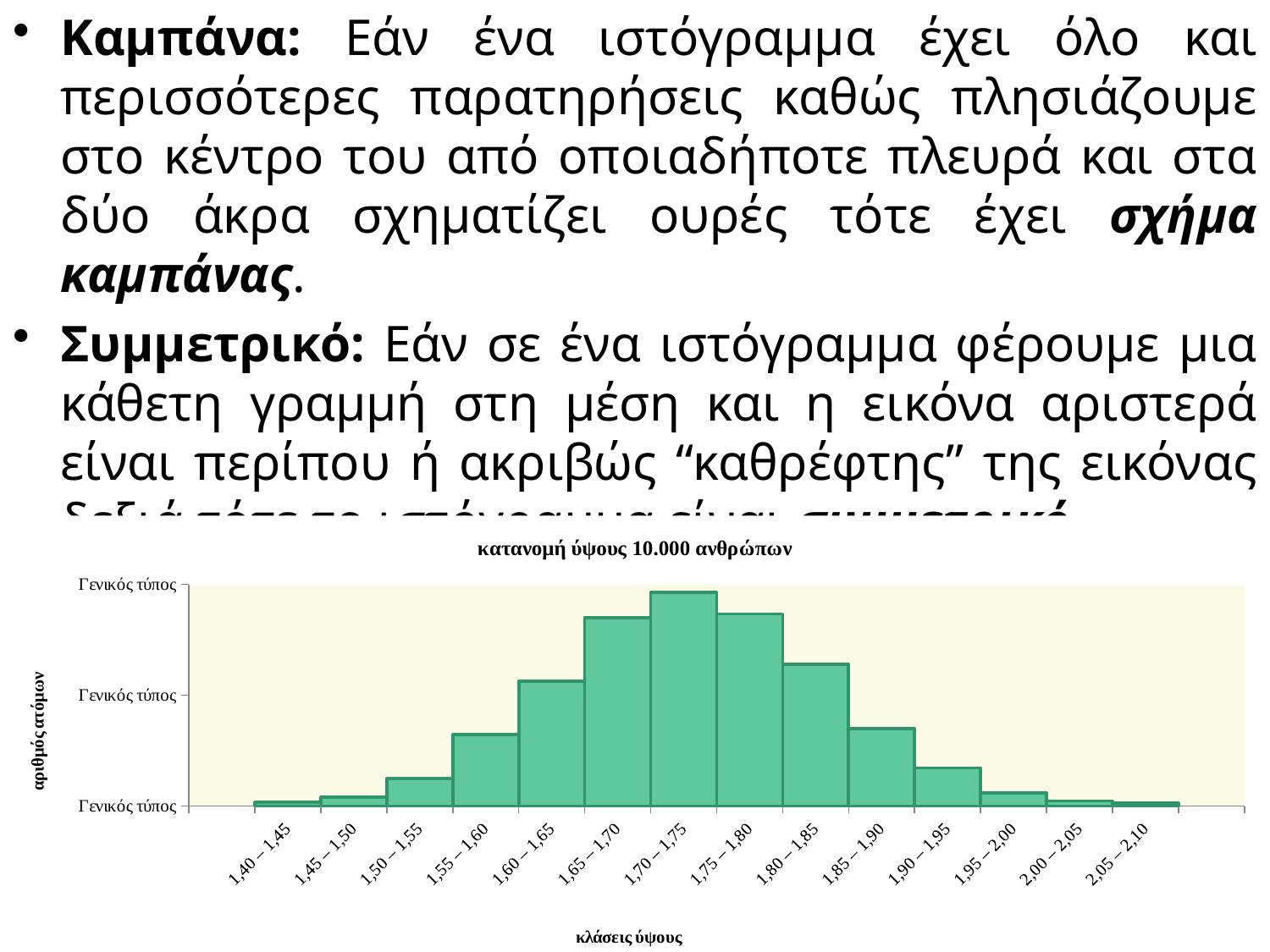
What is the title of the chart? κατανομή ύψους 10.000 ανθρώπων What kind of chart is shown on the slide? bar chart Which height class has the highest bar in the chart? 1,70 – 1,75 What is the label of the x axis of the chart? κλάσεις ύψους Which is the first height class on the left of the x axis? 1,40 – 1,45 Which is the last height class on the right of the x axis? 2,05 – 2,10 Which bar is taller: 1,65 – 1,70 or 1,85 – 1,90? 1,65 – 1,70 Which bar is taller: 1,75 – 1,80 or 1,95 – 2,00? 1,75 – 1,80 How many height classes (categories) are shown on the x axis of the chart? 14 Which bar is taller: 1,50 – 1,55 or 1,80 – 1,85? 1,80 – 1,85 How do the bar heights change moving from left to right along the x axis? They rise to a peak at 1,70 – 1,75 and then fall